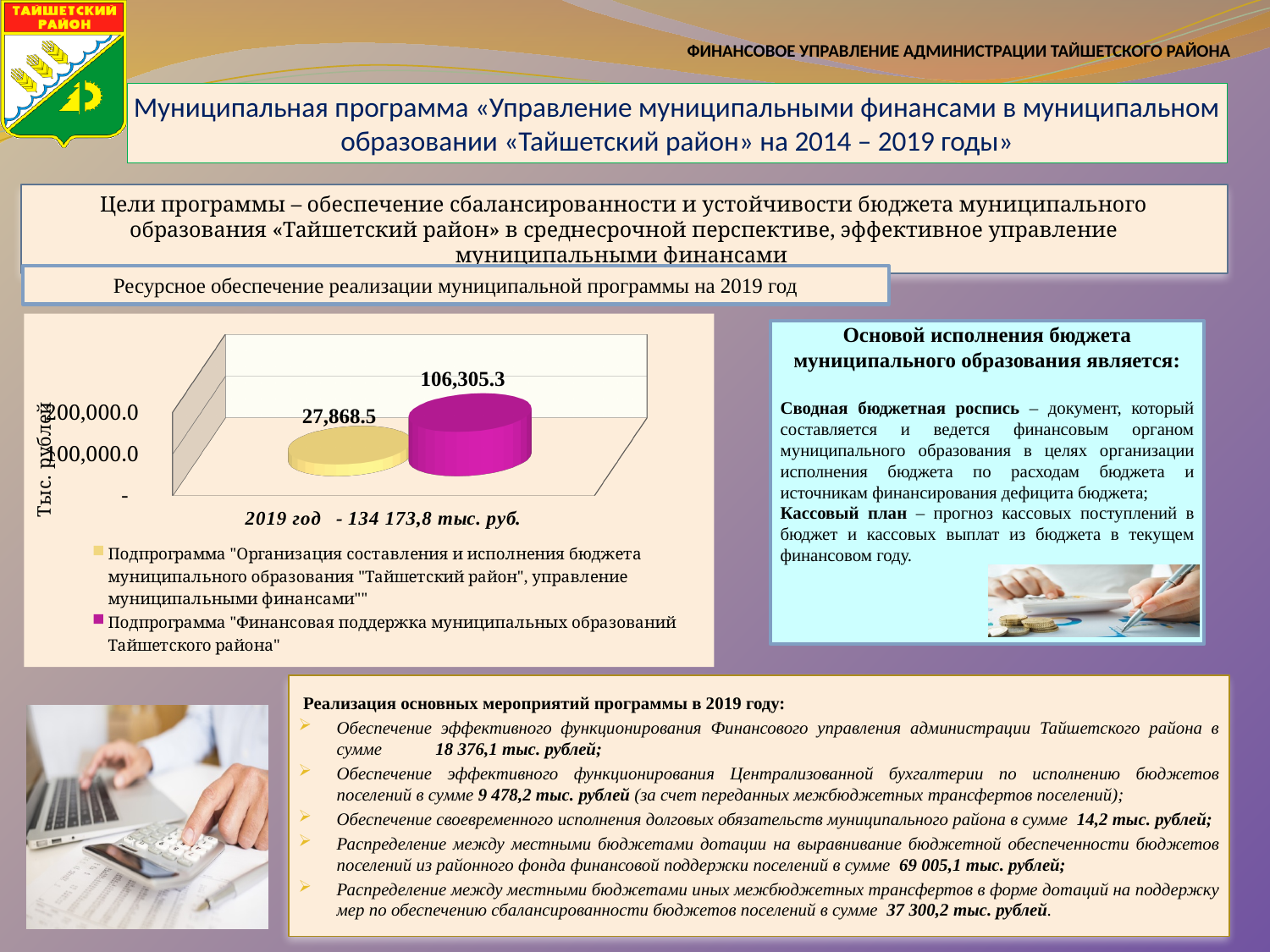
How many years (categories) are plotted on the x axis of the chart? 1 What is the total of the two values plotted for 2019, as printed under the chart? 134 173,8 тыс. руб. What kind of chart is shown on the slide? bar chart What value is shown for the subprogramme "Организация составления и исполнения бюджета муниципального образования "Тайшетский район", управление муниципальными финансами"? 27,868.5 Which subprogramme has the lower value in the chart? Подпрограмма "Организация составления и исполнения бюджета муниципального образования "Тайшетский район", управление муниципальными финансами" What value is shown for the subprogramme "Финансовая поддержка муниципальных образований Тайшетского района"? 106,305.3 What is the label of the chart's vertical axis? Тыс. рублей What is the difference between the two values plotted in the chart (106,305.3 and 27,868.5)? 78,436.8 How many series does the chart legend list? 2 Is the value for the subprogramme "Финансовая поддержка муниципальных образований Тайшетского района" larger or smaller than the value for the other subprogramme? larger Which subprogramme has the higher value in the chart? Подпрограмма "Финансовая поддержка муниципальных образований Тайшетского района" Which colour represents the subprogramme "Финансовая поддержка муниципальных образований Тайшетского района" in the chart? magenta